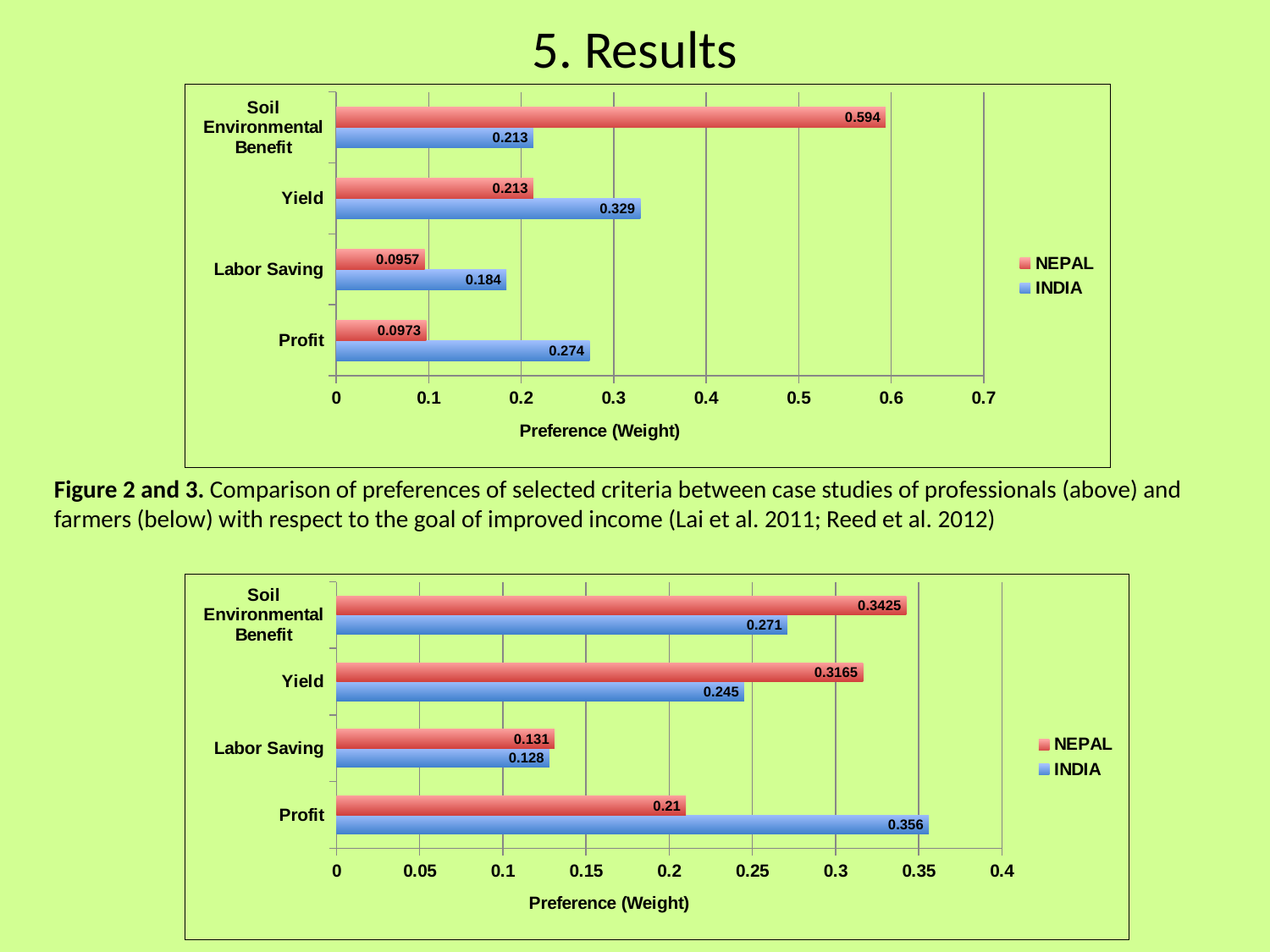
In the upper chart (professionals), which category has the lowest INDIA value? Labor Saving How many series does the legend of the lower chart (farmers) list? 2 What type of chart is the upper chart (professionals)? Bar chart In the lower chart (farmers), what is the NEPAL value for Yield? 0.3165 In the lower chart (farmers), which category has the highest INDIA value? Profit In the upper chart (professionals), what is the INDIA value for Yield? 0.329 In the upper chart (professionals), what is the difference between the INDIA and NEPAL values for Profit? 0.1767 In the lower chart (farmers), what is the difference between the NEPAL and INDIA values for Soil Environmental Benefit? 0.0715 In the lower chart (farmers), what is the INDIA value for Profit? 0.356 In the upper chart (professionals), which category has the highest NEPAL value? Soil Environmental Benefit In the upper chart (professionals), what is the NEPAL value for Soil Environmental Benefit? 0.594 In the upper chart (professionals), which is larger for Labor Saving, NEPAL or INDIA? INDIA